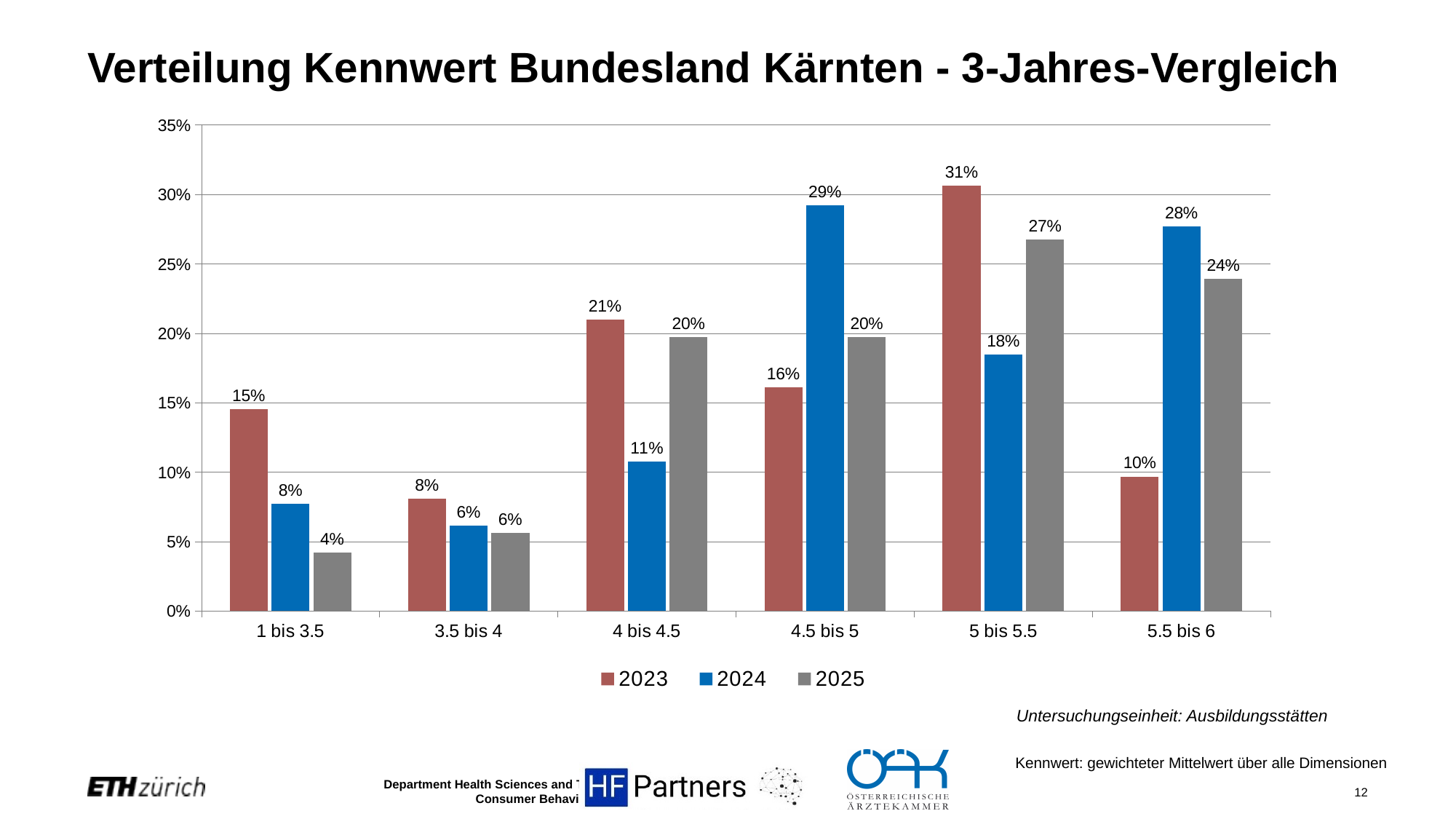
What kind of chart is shown on the slide? bar chart In the category "4 bis 4.5", which series has the larger value, 2023 or 2024? 2023 What is the value for 2025 in the category "1 bis 3.5"? 4% Which category has the lowest value for the 2023 series? 3.5 bis 4 What is the value for 2023 in the category "5 bis 5.5"? 31% Which category has the highest value for the 2025 series? 5 bis 5.5 Is the value for 2025 in the category "5.5 bis 6" greater or less than 20%? greater How many series does the legend list? 3 What is the difference between the 2024 and 2023 values in the category "5.5 bis 6"? 18% What is the title of the chart on the slide? Verteilung Kennwert Bundesland Kärnten - 3-Jahres-Vergleich How many categories are shown on the x axis? 6 What is the value for 2024 in the category "4.5 bis 5"? 29%